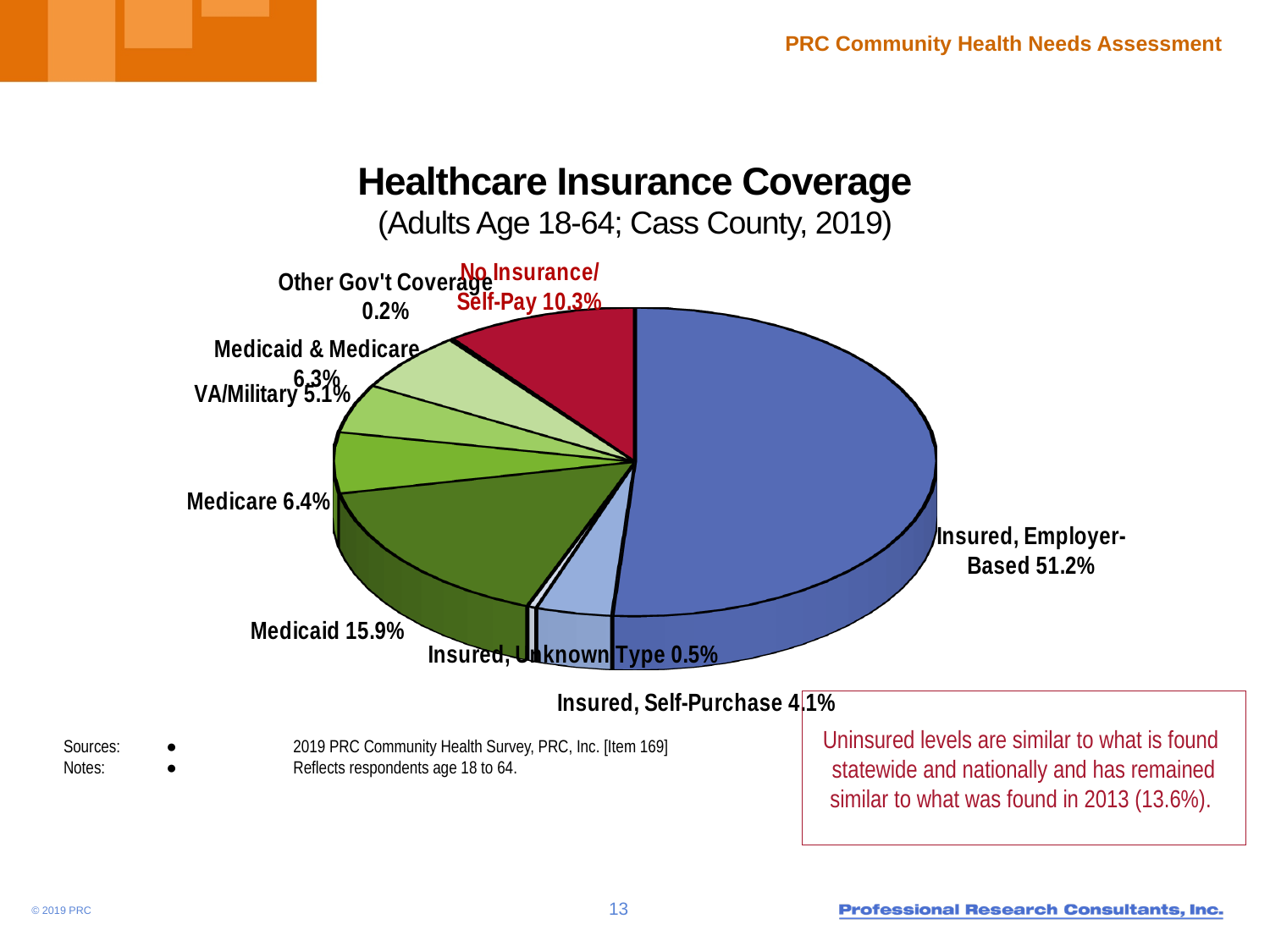
What kind of chart is shown on the slide? Pie chart What is the value for Medicaid? 15.9% What percentage of adults age 18-64 in Cass County have employer-based insurance? 51.2% Which is larger, Medicare or Medicaid & Medicare? Medicare Which category has the smallest slice of the pie? Other Gov't Coverage How many categories are shown in the pie chart? 9 Which category has the largest slice of the pie? Insured, Employer-Based What share of the pie is No Insurance/Self-Pay? 10.3% What is the difference between the Medicaid share and the No Insurance/Self-Pay share? 5.6% What is the title of the chart? Healthcare Insurance Coverage What is the value for VA/Military? 5.1% What is the value for Medicare? 6.4%